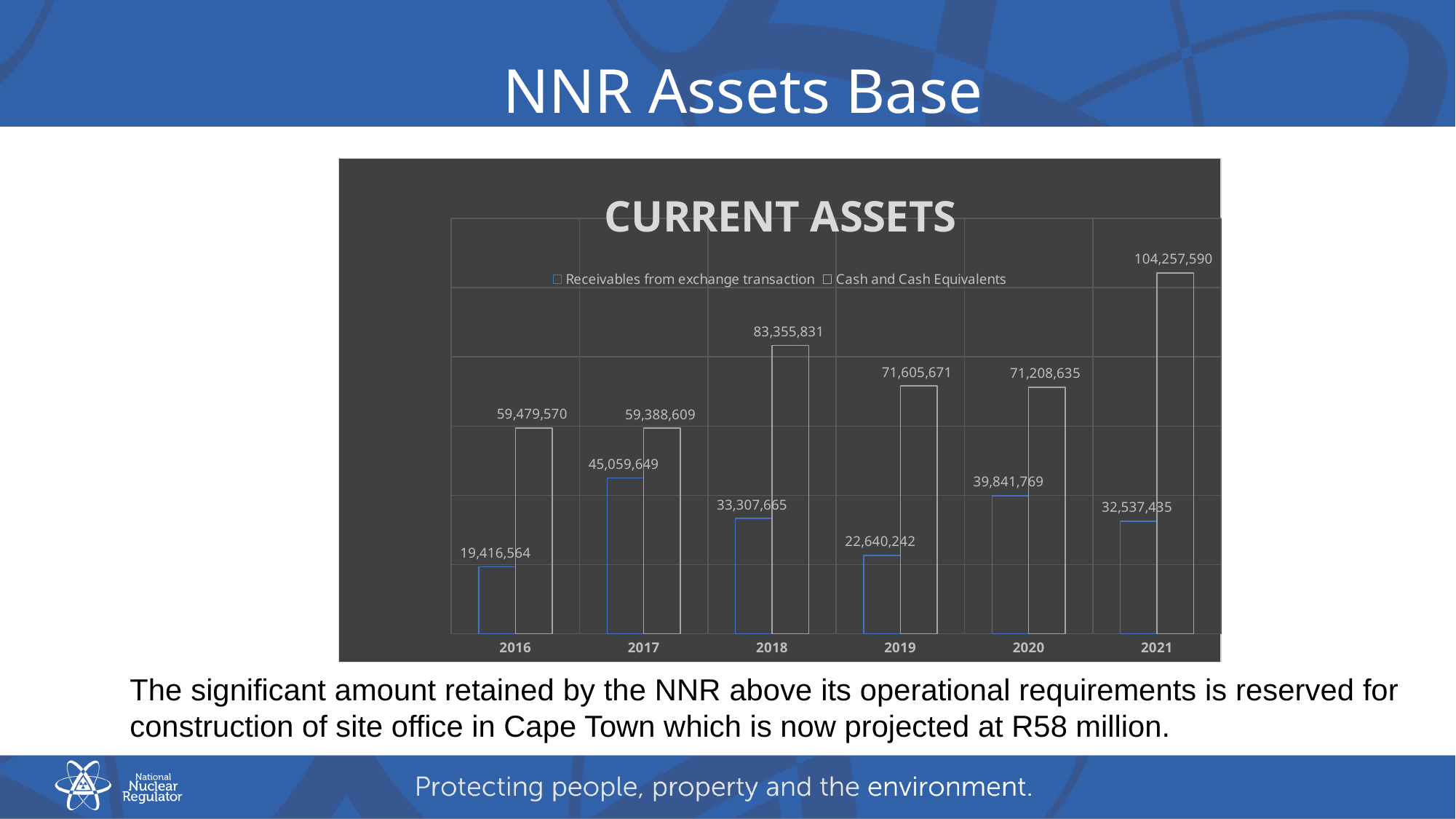
Which is larger: Receivables from exchange transaction in 2018 or in 2020? 2020 What is the value of Receivables from exchange transaction in 2016? 19,416,564 How many series does the legend list? 2 In which year is Receivables from exchange transaction highest? 2017 How many years are shown on the x axis? 6 In which year is Receivables from exchange transaction lowest? 2016 What is the difference between Cash and Cash Equivalents and Receivables from exchange transaction in 2021? 71,720,155 In which year is Cash and Cash Equivalents highest? 2021 What is the value of Cash and Cash Equivalents in 2018? 83,355,831 What is the value of Receivables from exchange transaction in 2020? 39,841,769 What kind of chart is shown? Bar chart What is the value of Cash and Cash Equivalents in 2021? 104,257,590